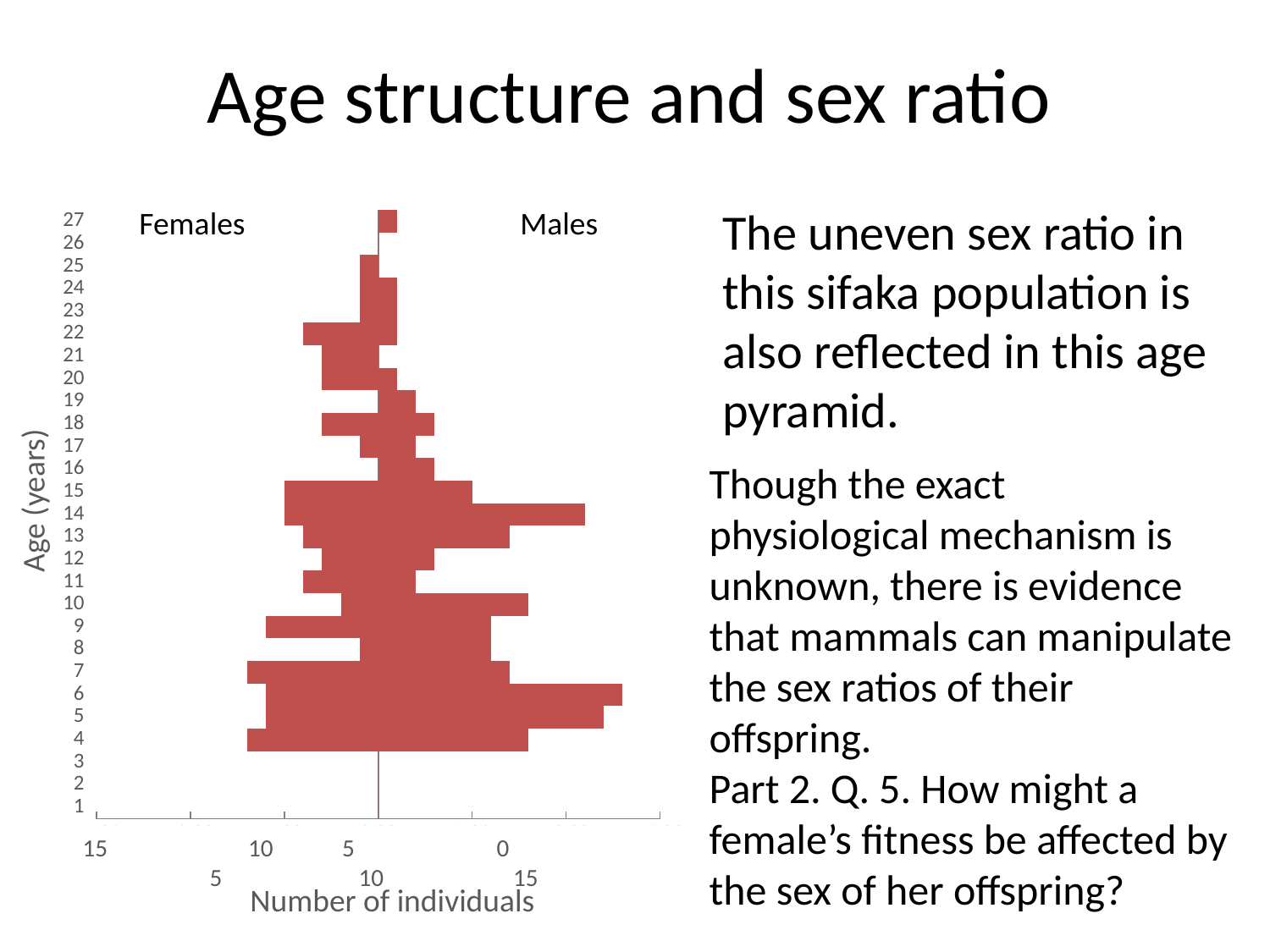
What is the label of the vertical axis of the age pyramid? Age (years) How many age categories are listed on the vertical axis of the age pyramid? 27 At age 10, are there more males or more females? Males Overall, which side of the pyramid, Females or Males, shows more individuals? Males At age 14, are there more males or more females? Males Which age has the widest combined bar (females plus males) in the pyramid? 6 What is the oldest age shown with any individuals in the pyramid? 27 How many groups (sexes) are plotted in the age pyramid? 2 What type of chart is shown on the slide? Bar chart Which age has the longest bar on the Males side of the pyramid? 6 What is the label of the horizontal axis of the age pyramid? Number of individuals